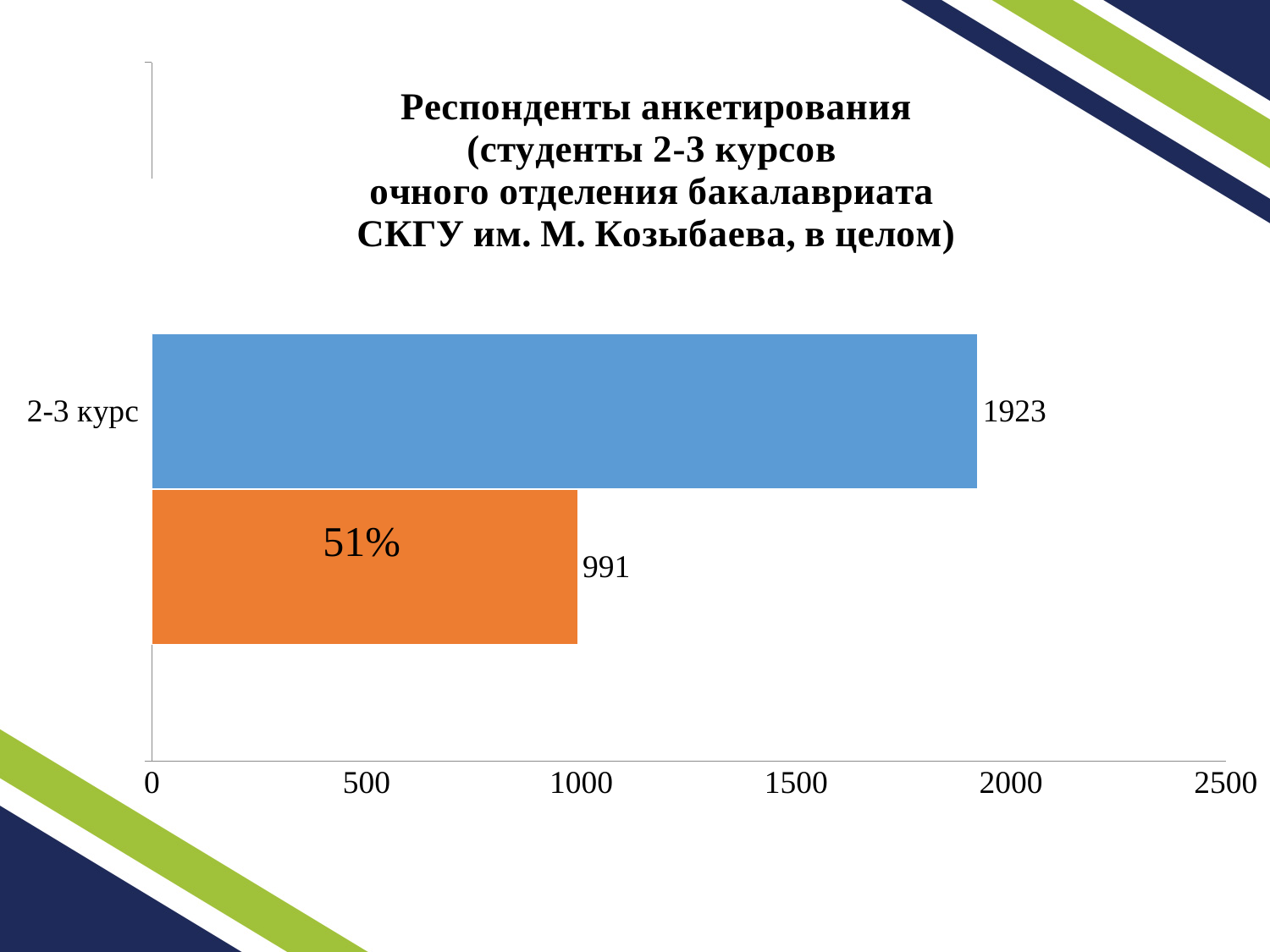
Is the value of the orange bar greater or less than 1000? less How many category labels are shown on the vertical axis? 1 What is the highest value shown on the chart? 1923 What percentage label is printed on the orange bar? 51% What value is shown for the orange bar? 991 What value is shown for the blue bar? 1923 What kind of chart is shown on the slide? bar chart Is the value of the blue bar greater or less than 1500? greater What is the difference between the blue bar value and the orange bar value? 932 Which bar is larger, the blue one or the orange one? the blue one What is the lowest value shown on the chart? 991 What is the category label on the vertical axis of the chart? 2-3 курс